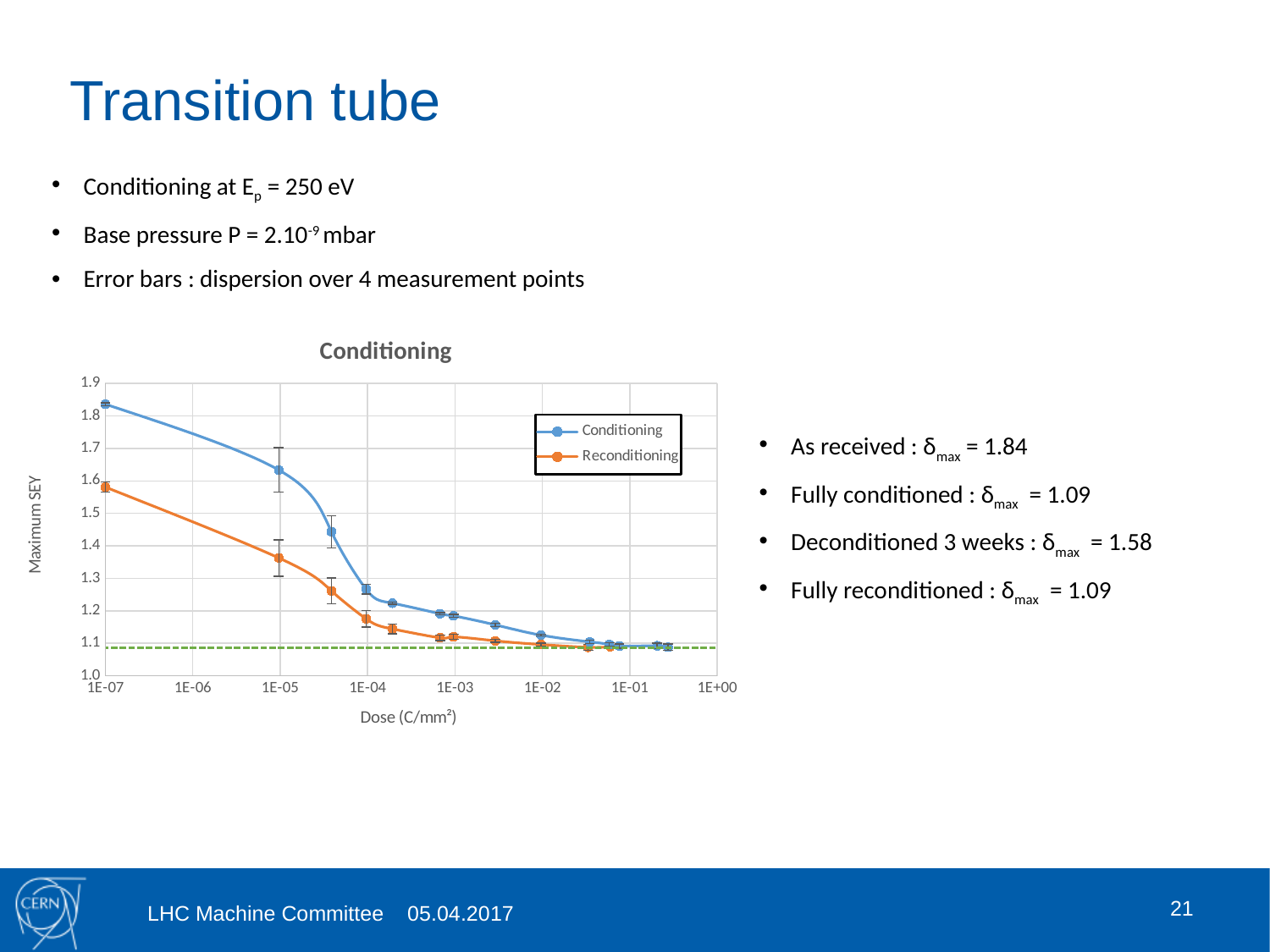
Is the value of the Reconditioning series at a dose of 1E-05 greater or less than 1.5? less What is the title of the chart? Conditioning At which dose does the Conditioning series reach its highest Maximum SEY? 1E-07 How many series does the chart legend list? 2 Does the Conditioning series rise or fall as the dose increases along the x axis? fall Is the value of the Reconditioning series at a dose of 1E-04 greater or less than 1.3? less Does the Reconditioning series rise or fall as the dose increases along the x axis? fall Is the value of the Conditioning series at a dose of 1E-05 greater or less than 1.5? greater At a dose of 1E-05, which series has the higher Maximum SEY, Conditioning or Reconditioning? Conditioning What kind of chart is shown on the slide? line chart What is the label of the x axis of the chart? Dose (C/mm²)